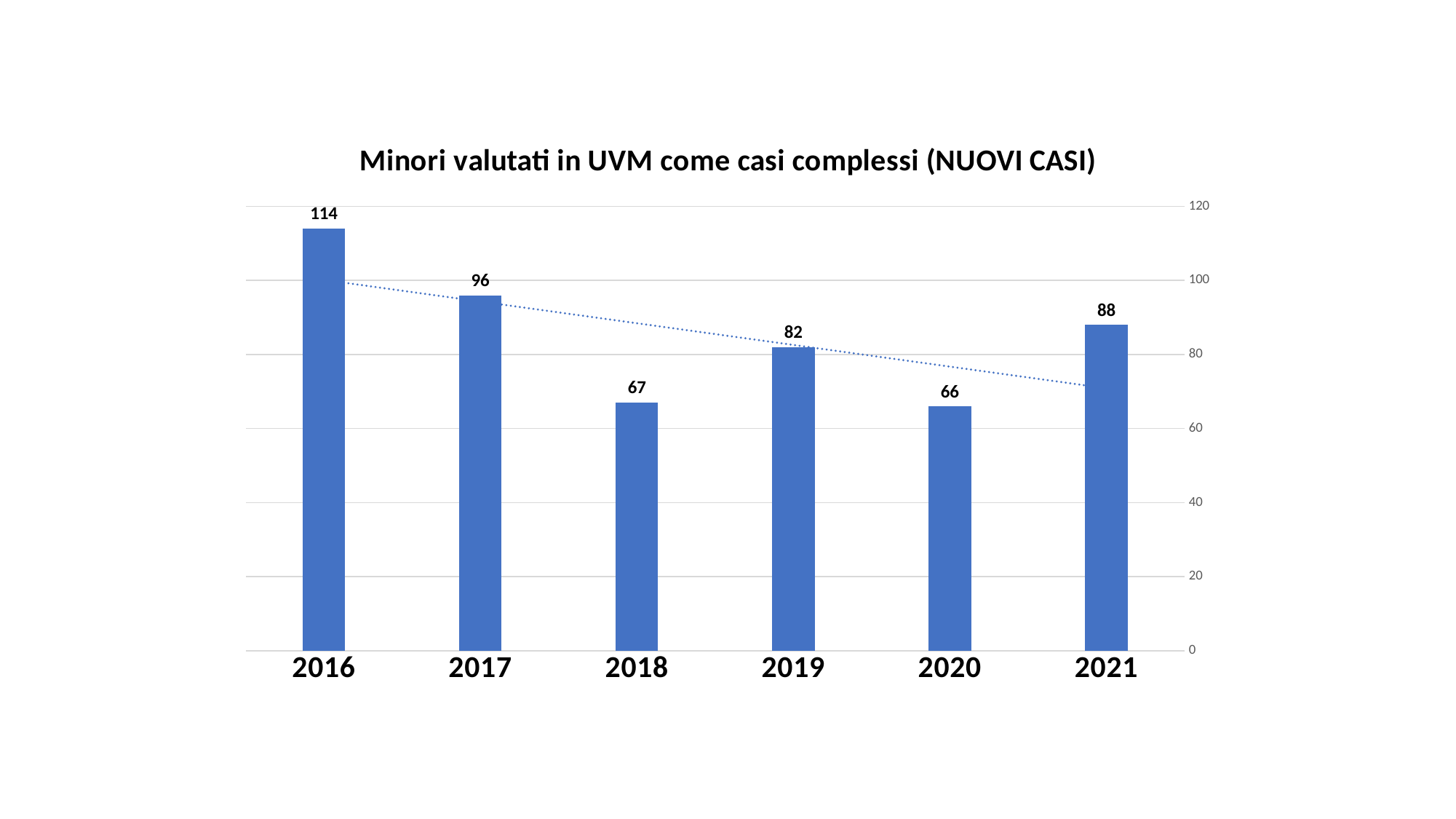
What is the difference between the values for 2021 and 2020? 22 What is the title of the chart? Minori valutati in UVM come casi complessi (NUOVI CASI) Which is larger, the value for 2019 or the value for 2018? 2019 What is the value for 2016? 114 How many years are shown on the x axis? 6 What is the value for 2020? 66 Which year has the highest value? 2016 Which year has the lowest value? 2020 What is the value for 2021? 88 What is the difference between the values for 2016 and 2017? 18 Is the value for 2017 greater or less than 100? less What kind of chart is this? bar chart